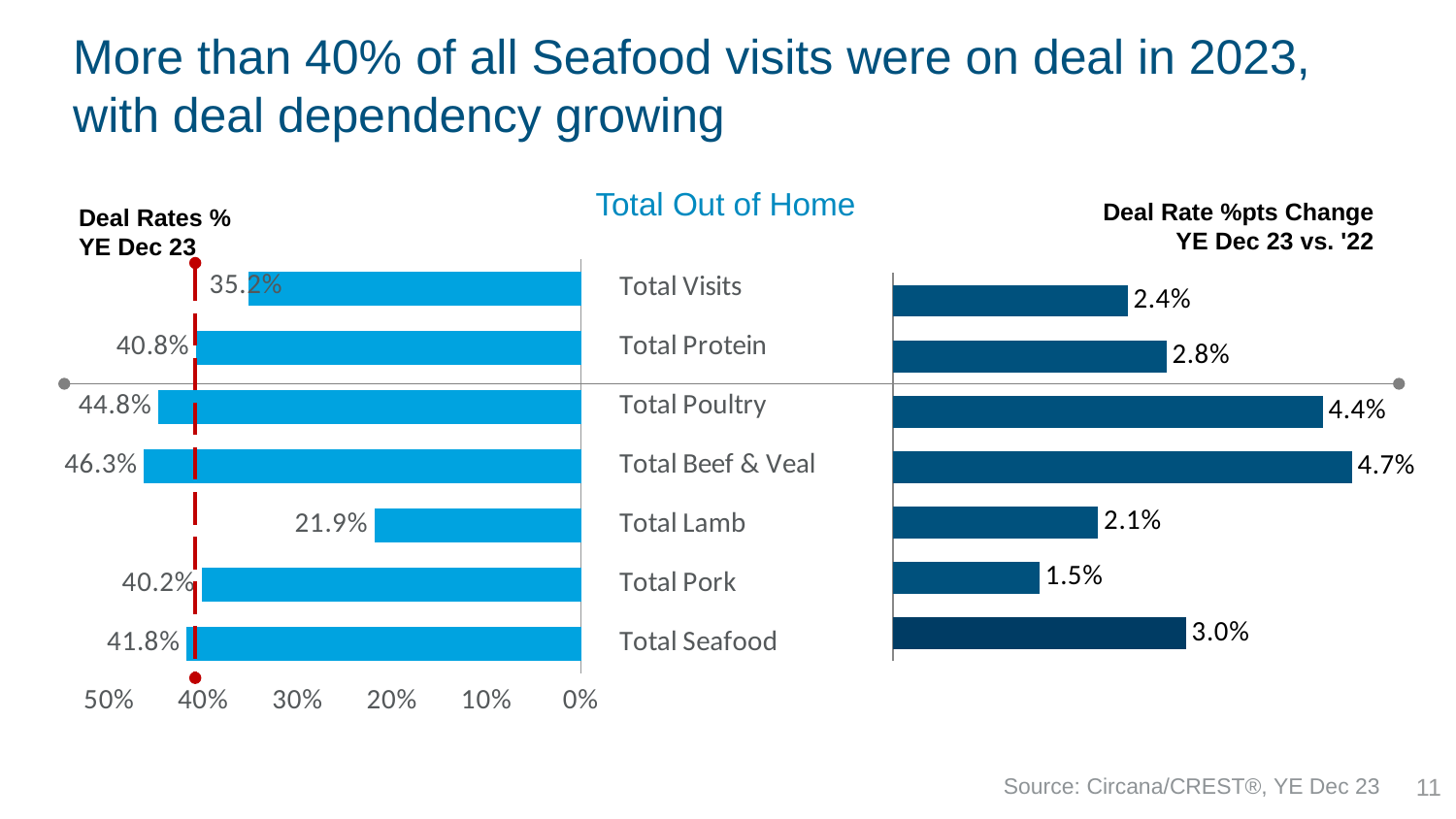
In the Deal Rate %pts Change YE Dec 23 vs. '22 chart, what is the value for Total Pork? 1.5% In the Deal Rates % YE Dec 23 chart, which category has the highest deal rate? Total Beef & Veal What type of chart is the Deal Rate %pts Change YE Dec 23 vs. '22 chart? Bar chart In the Deal Rates % YE Dec 23 chart, which category has the lowest deal rate? Total Lamb In the Deal Rates % YE Dec 23 chart, what is the deal rate for Total Seafood? 41.8% In the Deal Rate %pts Change YE Dec 23 vs. '22 chart, which category has the largest change? Total Beef & Veal In the Deal Rate %pts Change YE Dec 23 vs. '22 chart, what is the value for Total Seafood? 3.0% In the Deal Rate %pts Change YE Dec 23 vs. '22 chart, which category has the smallest change? Total Pork How many categories are shown in the Deal Rates % YE Dec 23 chart? 7 In the Deal Rates % YE Dec 23 chart, what is the deal rate for Total Lamb? 21.9% In the Deal Rates % YE Dec 23 chart, what is the difference between the deal rates for Total Poultry and Total Visits? 9.6% In the Deal Rate %pts Change YE Dec 23 vs. '22 chart, which is larger, the value for Total Poultry or Total Protein? Total Poultry